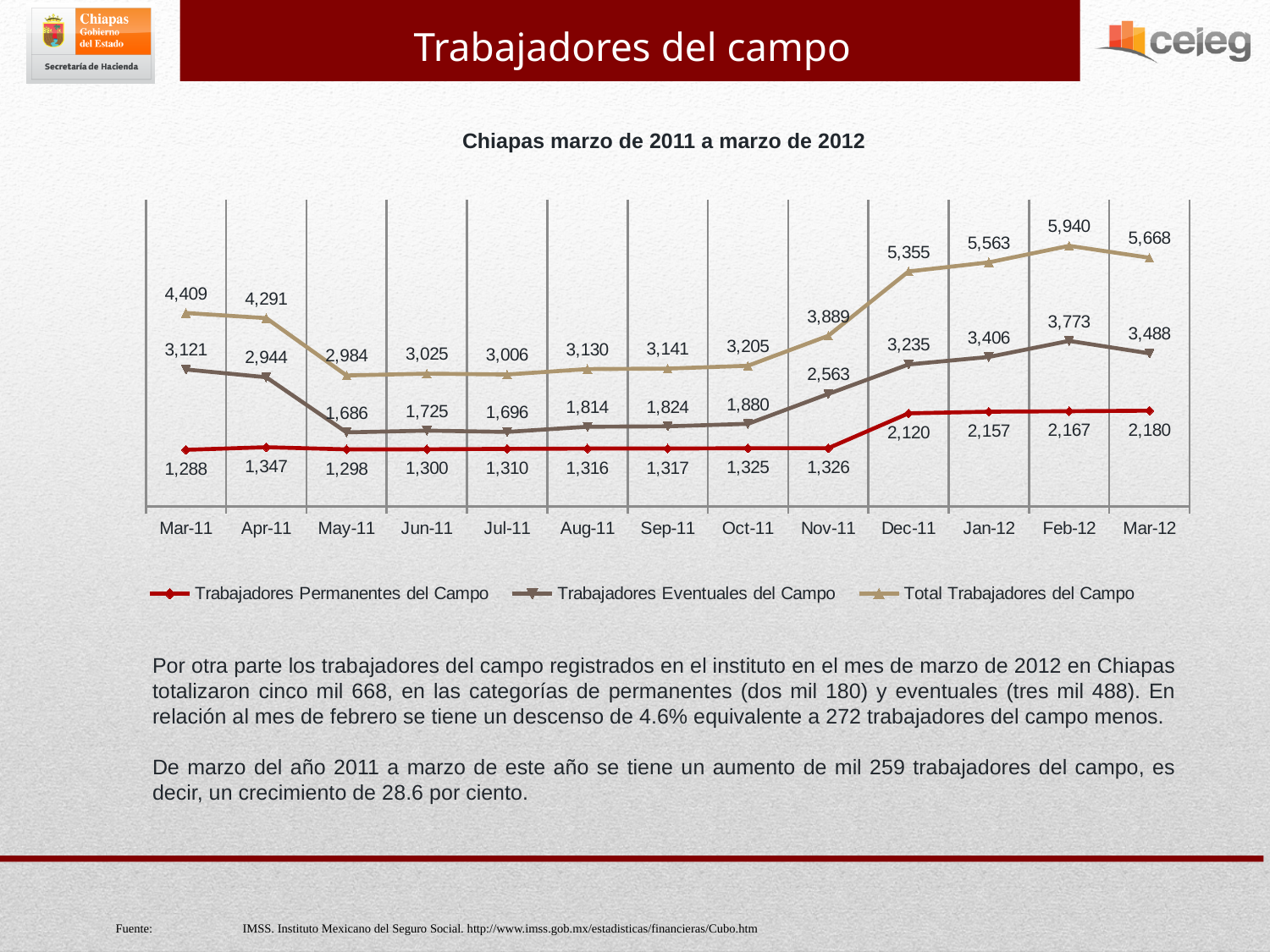
How many series does the legend list? 3 What is the difference between Total Trabajadores del Campo in Feb-12 and Mar-12? 272 Does Trabajadores Permanentes del Campo rise or fall from Nov-11 to Dec-11? Rise How many months are plotted along the x axis? 13 What is the title shown above the chart? Chiapas marzo de 2011 a marzo de 2012 What is the value of Total Trabajadores del Campo in Mar-12? 5,668 Which is larger: Trabajadores Eventuales del Campo in Mar-11 or in Dec-11? Dec-11 What is the value of Trabajadores Permanentes del Campo in Apr-11? 1,347 In which month is Trabajadores Permanentes del Campo at its lowest value? Mar-11 In which month does Total Trabajadores del Campo reach its highest value? Feb-12 What is the value of Trabajadores Eventuales del Campo in Nov-11? 2,563 What type of chart is shown on the slide? Line chart